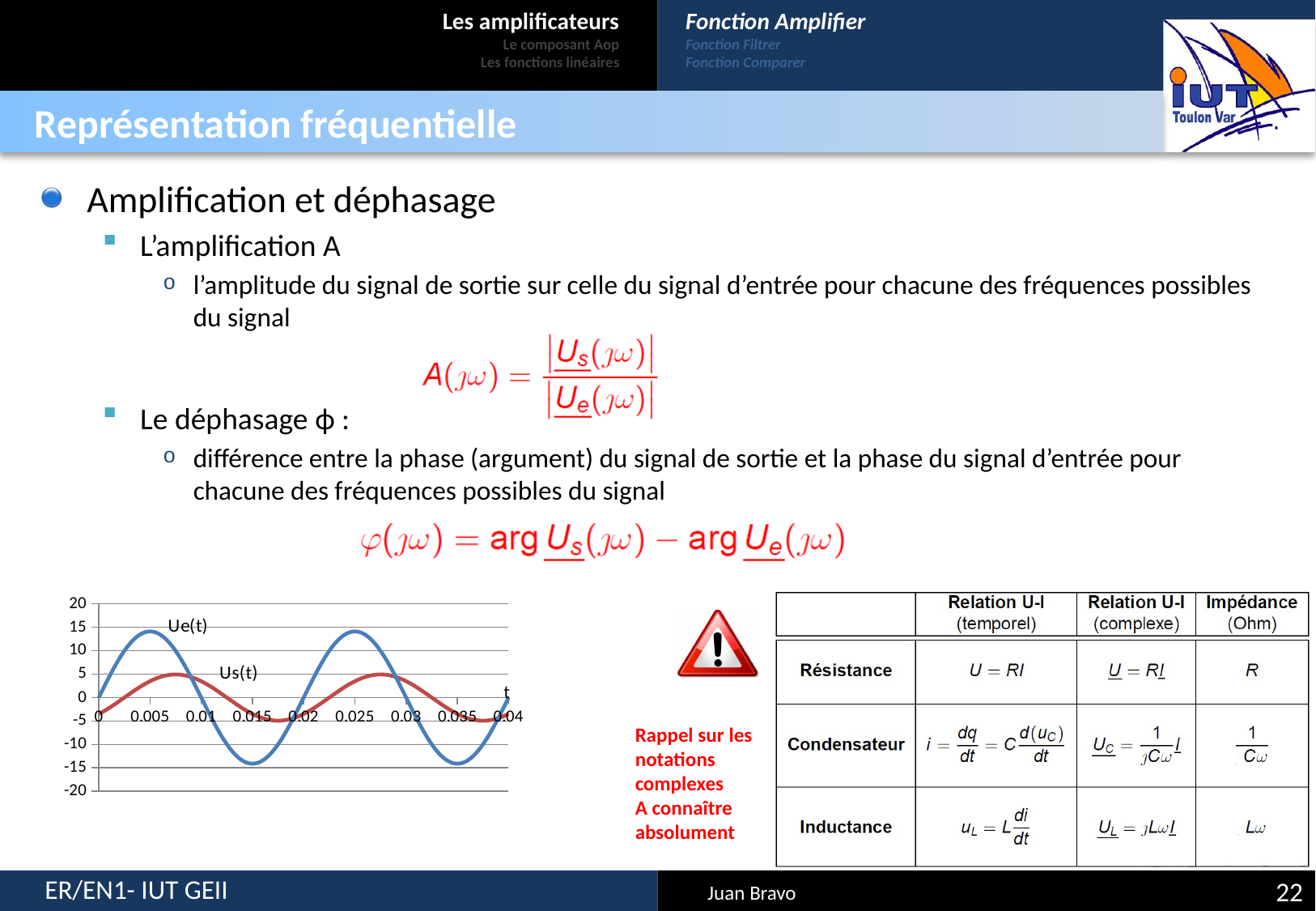
What is the largest value shown on the horizontal axis of the chart at the bottom left? 0.04 On the chart at the bottom left, is the minimum value of Us(t) greater or less than -10? greater On the chart at the bottom left, is the minimum value of Ue(t) greater or less than -10? less What kind of chart is shown at the bottom left of the slide? line chart How many tick labels are shown on the horizontal axis of the chart at the bottom left? 9 How many series are plotted on the chart at the bottom left of the slide? 2 What is the highest value shown on the vertical axis of the chart at the bottom left? 20 What are the names of the two series plotted on the chart at the bottom left? Ue(t) and Us(t) On the chart at the bottom left, is the peak value of Ue(t) greater or less than 10? greater On the chart at the bottom left, which series has the larger amplitude, Ue(t) or Us(t)? Ue(t) On the chart at the bottom left, what colour is the Us(t) line? red